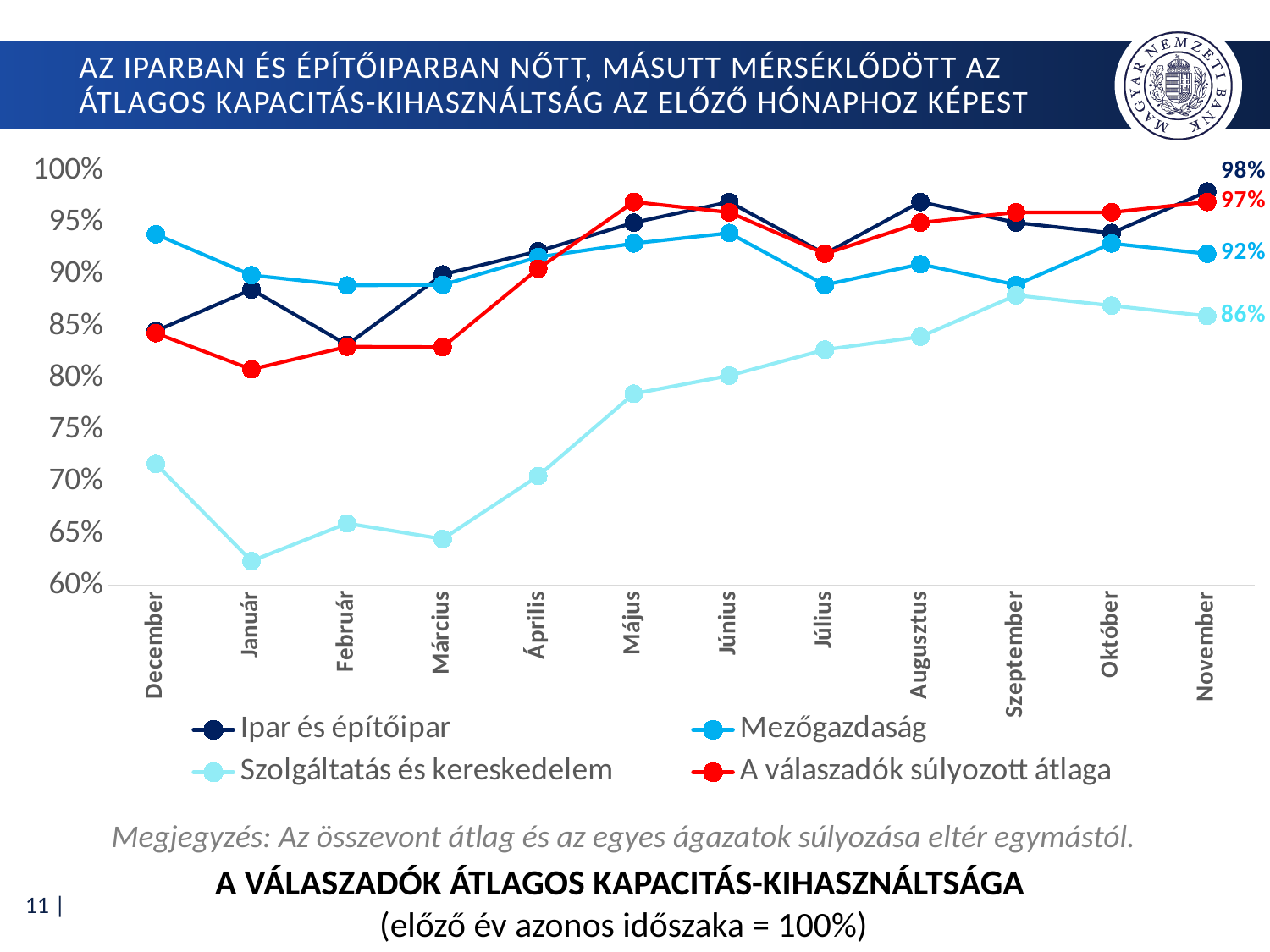
In which month does Szolgáltatás és kereskedelem reach its lowest value? Január What is the value for A válaszadók súlyozott átlaga in November? 97% In November, what is the difference between the values for Ipar és építőipar and Szolgáltatás és kereskedelem? 12 percentage points How many series does the legend list? 4 How many months are shown on the x axis? 12 Which series has the lowest value in November? Szolgáltatás és kereskedelem Which series has the highest value in November? Ipar és építőipar What is the value for Szolgáltatás és kereskedelem in November? 86% What kind of chart is shown on the slide? Line chart What is the value for Mezőgazdaság in November? 92% What is the value for Ipar és építőipar in November? 98% Is the value for Szolgáltatás és kereskedelem in Január greater or less than 65%? less